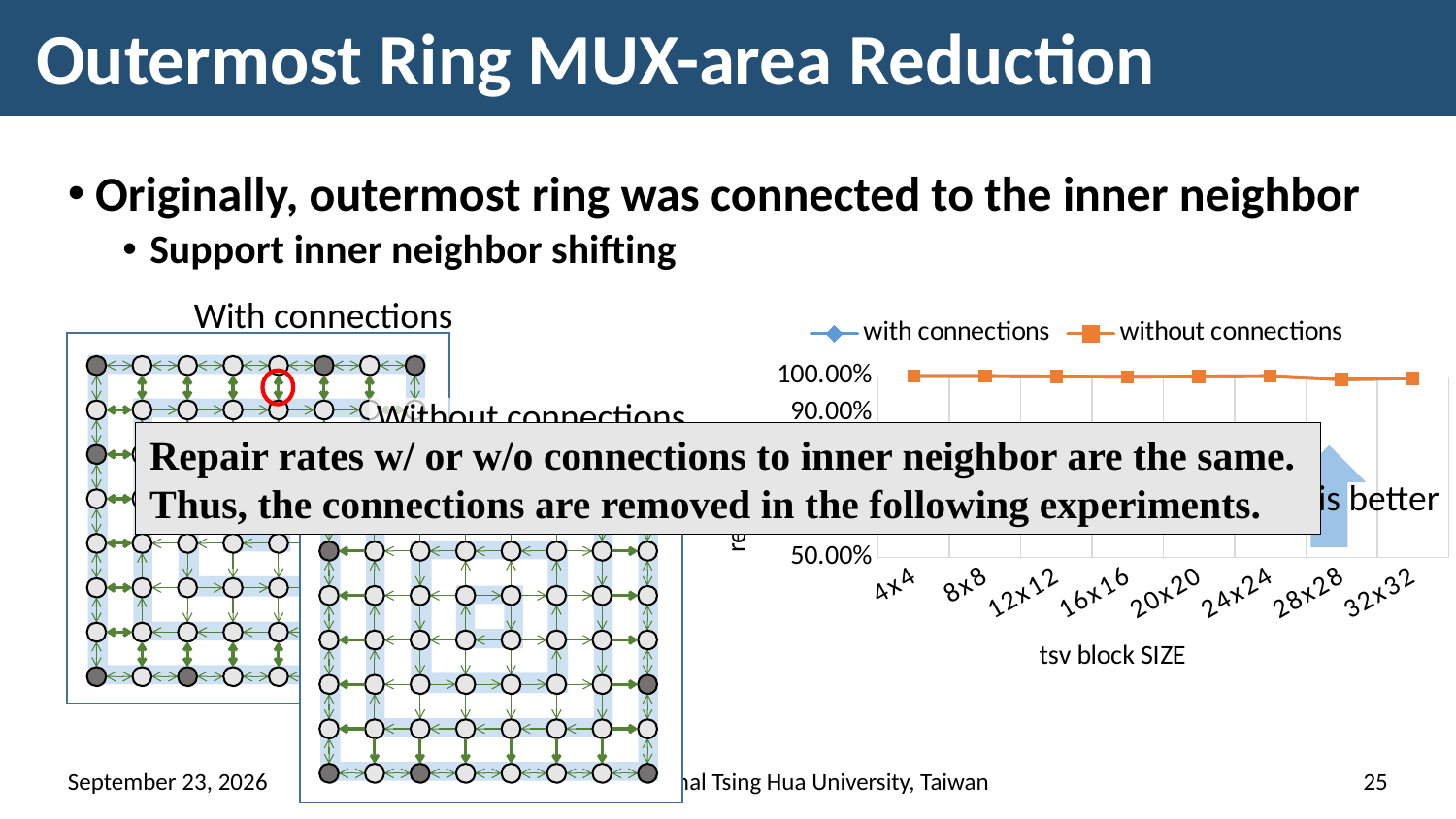
Is the value for 32x32 in the 'without connections' series greater or less than 90.00%? greater What kind of chart is shown on the right side of the slide? line chart Is the value for 4x4 in the 'without connections' series greater or less than 90.00%? greater Which tsv block size is the first category on the x axis of the chart? 4x4 What are the two series named in the chart legend? with connections, without connections What is the x-axis title of the chart? tsv block SIZE Do the 'without connections' values rise sharply, fall sharply, or stay roughly flat as the tsv block size increases from 4x4 to 32x32? stay roughly flat Is the value for 28x28 in the 'without connections' series greater or less than 90.00%? greater How many tsv block sizes are plotted along the x axis of the chart? 8 How many series does the legend of the chart list? 2